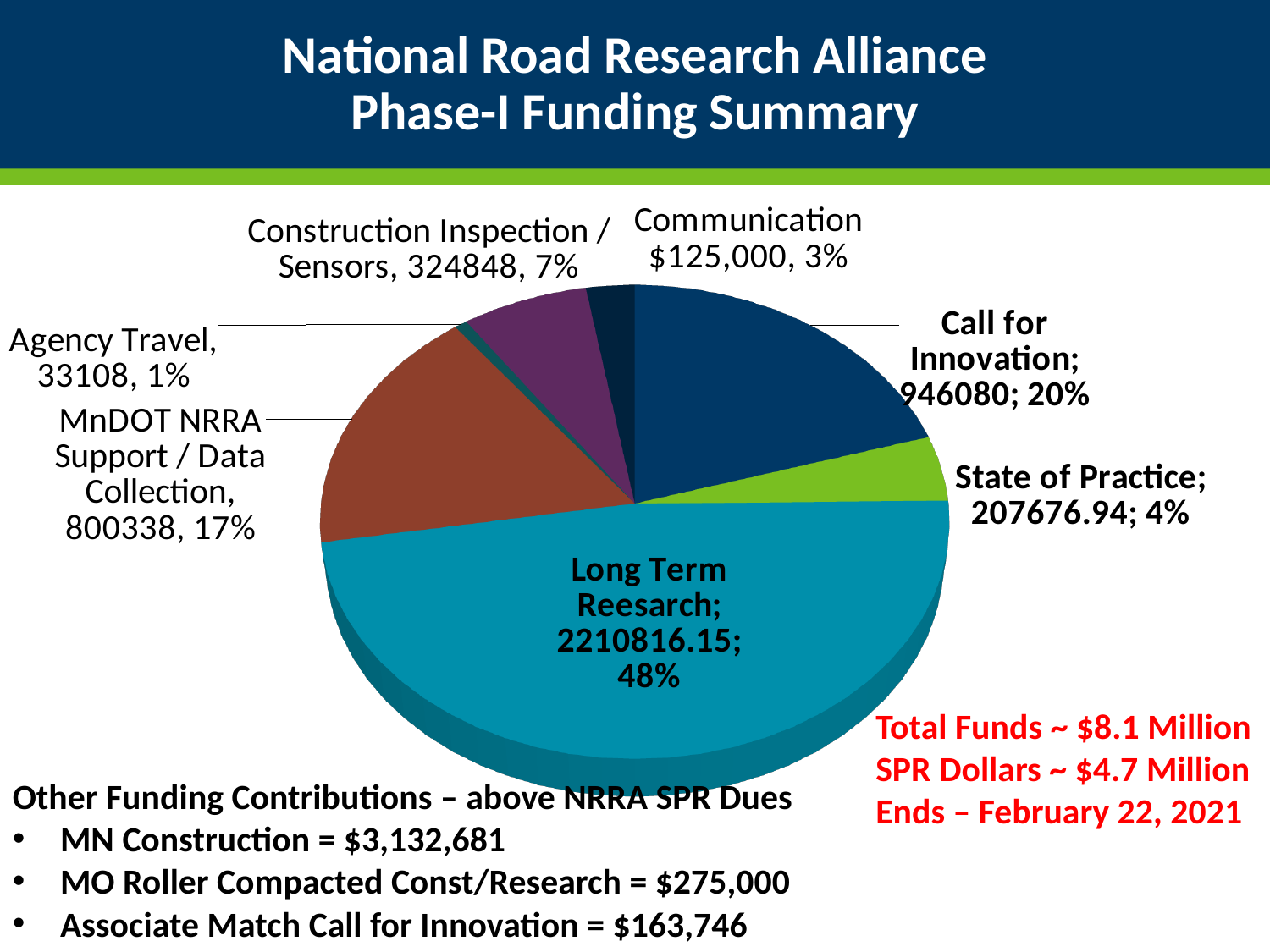
Which category has the largest slice of the pie? Long Term Reesarch Which category has the smallest slice of the pie? Agency Travel Which is larger, Construction Inspection / Sensors or Communication? Construction Inspection / Sensors What is the difference between the values for Call for Innovation and MnDOT NRRA Support / Data Collection? 145742 What is the value shown for State of Practice? 207676.94 How many slices does the pie chart have? 7 What is the value shown for Call for Innovation? 946080 What is the value shown for Agency Travel? 33108 What percentage share does Long Term Reesarch have? 48% What kind of chart is shown on the slide? pie chart What percentage share does MnDOT NRRA Support / Data Collection have? 17% What is the title of the slide containing the chart? National Road Research Alliance Phase-I Funding Summary